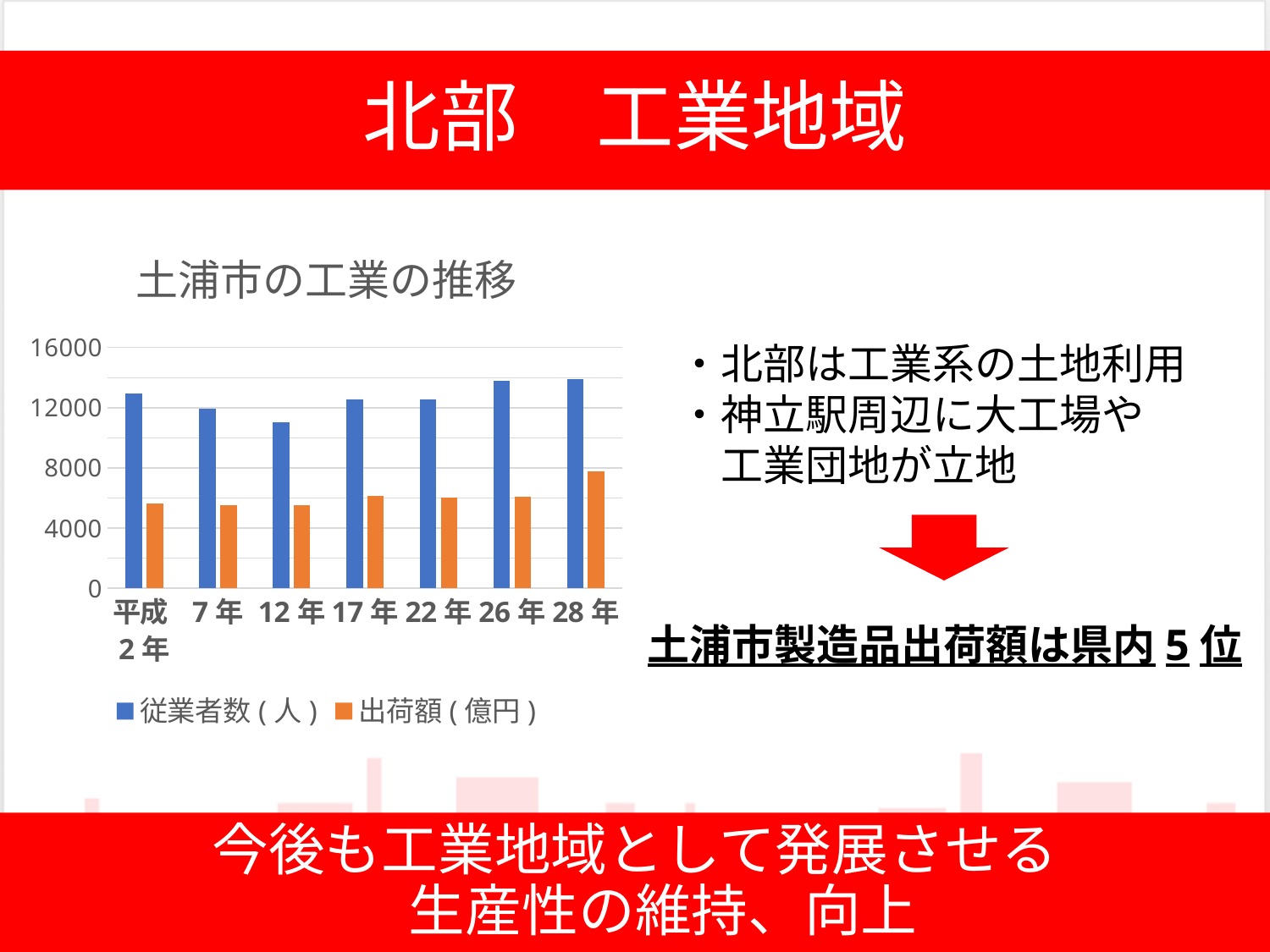
Does the value for 従業者数(人) rise or fall from 平成2年 to 12年? fall What is the title of the chart? 土浦市の工業の推移 Which year has the highest value for 出荷額(億円)? 28年 How many series does the chart legend list? 2 How many year categories are shown on the x axis of the chart? 7 Is the value for 従業者数(人) in 12年 greater or less than 12000? less Which series is shown in orange in the chart? 出荷額(億円) Which year has the lowest value for 従業者数(人)? 12年 What type of chart is shown on the slide? Bar chart Which is larger in 28年: 従業者数(人) or 出荷額(億円)? 従業者数(人) Is the value for 従業者数(人) in 平成2年 greater or less than 12000? greater